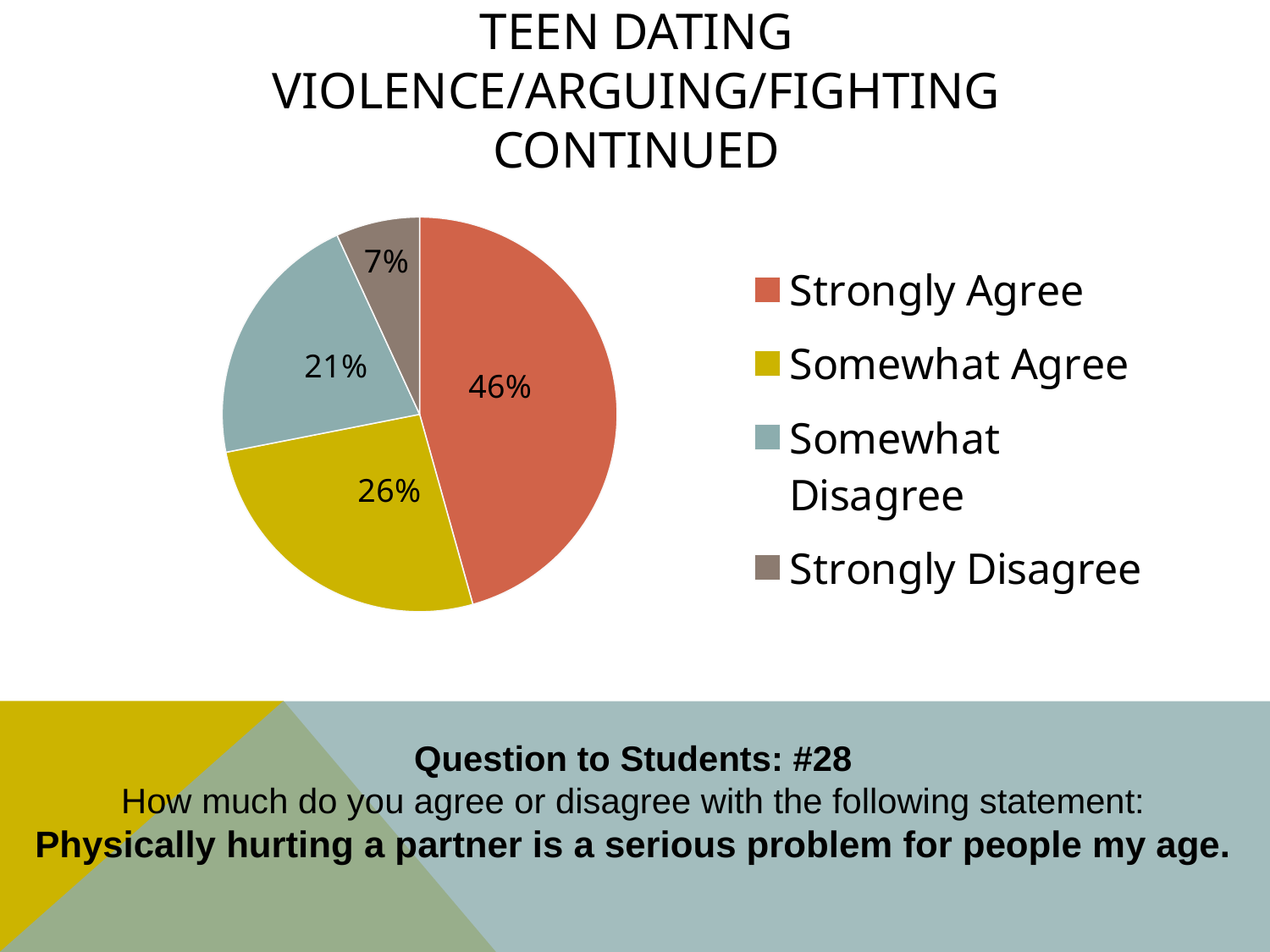
What colour is the "Strongly Agree" slice in the pie chart? Red/orange What percentage of students responded "Somewhat Disagree"? 21% Which response category has the smallest share of the pie? Strongly Disagree What is the difference in percentage points between "Somewhat Disagree" and "Strongly Disagree"? 14 What type of chart is shown on the slide? Pie chart Which is larger: the share for "Somewhat Agree" or the share for "Somewhat Disagree"? Somewhat Agree What percentage of students responded "Strongly Disagree"? 7% What is the difference in percentage points between "Strongly Agree" and "Somewhat Agree"? 20 What percentage of students responded "Somewhat Agree"? 26% Which response category has the largest share of the pie? Strongly Agree What percentage of students responded "Strongly Agree"? 46% How many response categories are shown in the pie chart? 4